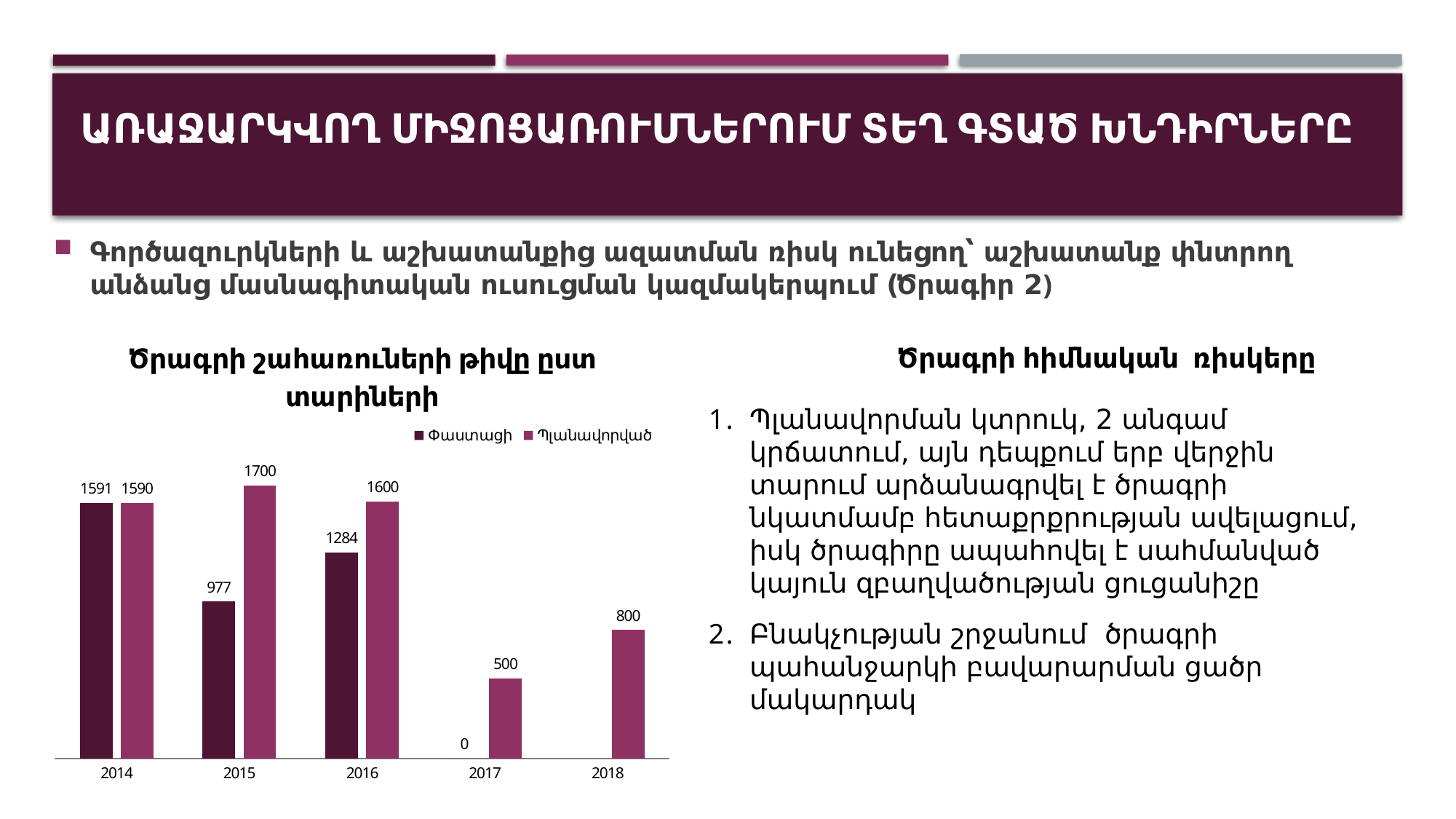
Which is larger for 2016, the Փաստացի (actual) value or the Պլանավորված (planned) value? Պլանավորված (planned) What type of chart is shown on the slide? bar chart How many years are shown on the x axis of the chart? 5 Which year has the lowest Պլանավորված (planned) value? 2017 What is the Փաստացի (actual) value for 2014? 1591 What is the Պլանավորված (planned) value for 2018? 800 What is the Պլանավորված (planned) value for 2015? 1700 Which series is shown in the darker colour in the chart? Փաստացի How many series does the chart legend list? 2 Which year has the highest Պլանավորված (planned) value? 2015 What is the Փաստացի (actual) value for 2016? 1284 What is the difference between the Պլանավորված (planned) and Փաստացի (actual) values for 2015? 723